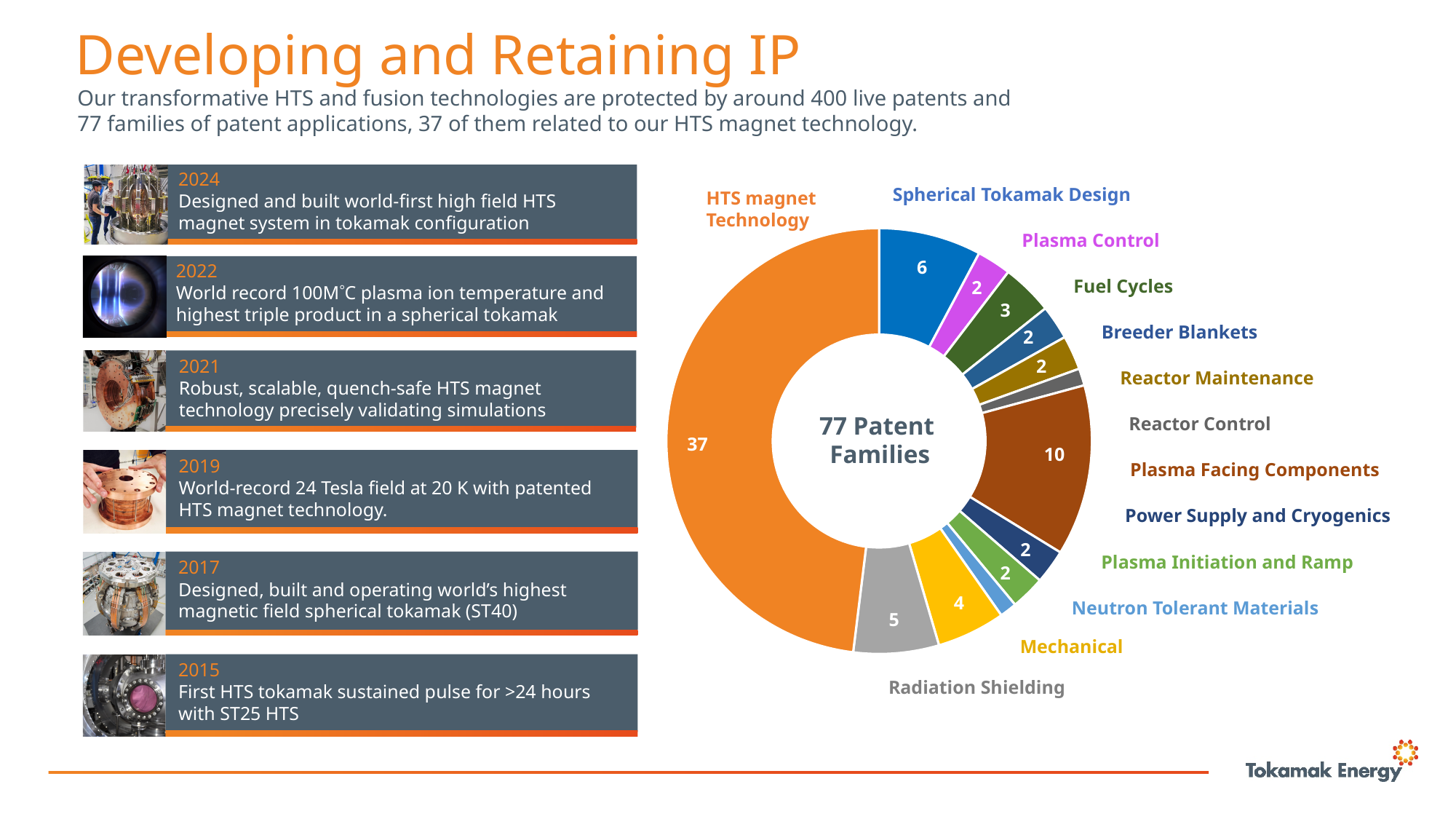
What kind of chart is shown on the slide? Donut (pie) chart How many patent families are shown for Spherical Tokamak Design? 6 Which is larger, Spherical Tokamak Design or Radiation Shielding? Spherical Tokamak Design What value does the chart show for Radiation Shielding? 5 How many patent families are shown for Fuel Cycles? 3 How many categories are labelled around the donut chart? 13 How many patent families does the donut chart show for HTS magnet Technology? 37 What text appears in the centre of the donut chart? 77 Patent Families What is the difference between the HTS magnet Technology value and the Plasma Facing Components value? 27 Which category has the largest segment in the donut chart? HTS magnet Technology What value is shown for Mechanical in the donut chart? 4 What value is shown for Plasma Facing Components in the donut chart? 10